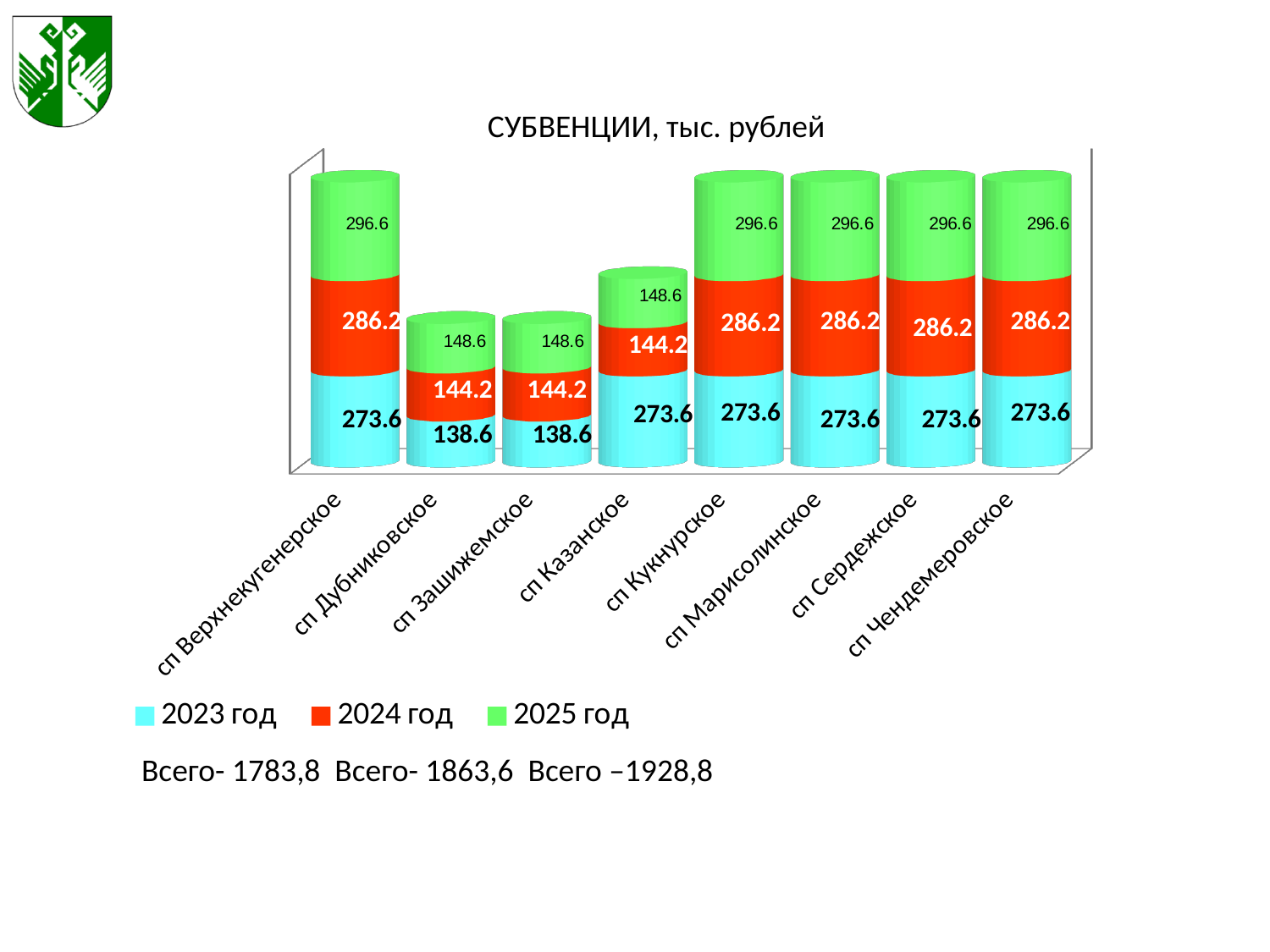
What is the value for сп Чендемеровское in the 2025 год series? 296.6 What is the total of the stacked bar for сп Верхнекугенерское? 856.4 What is the title of the chart? СУБВЕНЦИИ, тыс. рублей For сп Казанское, which is larger: the 2023 год value or the 2024 год value? 2023 год What is the difference between the 2025 год values for сп Верхнекугенерское and сп Дубниковское? 148 For сп Сердежское, which series has the highest value? 2025 год How many series does the legend list? 3 What is the value for сп Казанское in the 2024 год series? 144.2 What is the value for сп Дубниковское in the 2023 год series? 138.6 What is the total of the stacked bar for сп Казанское? 566.4 How many categories are shown on the x axis? 8 What is the value for сп Зашижемское in the 2025 год series? 148.6